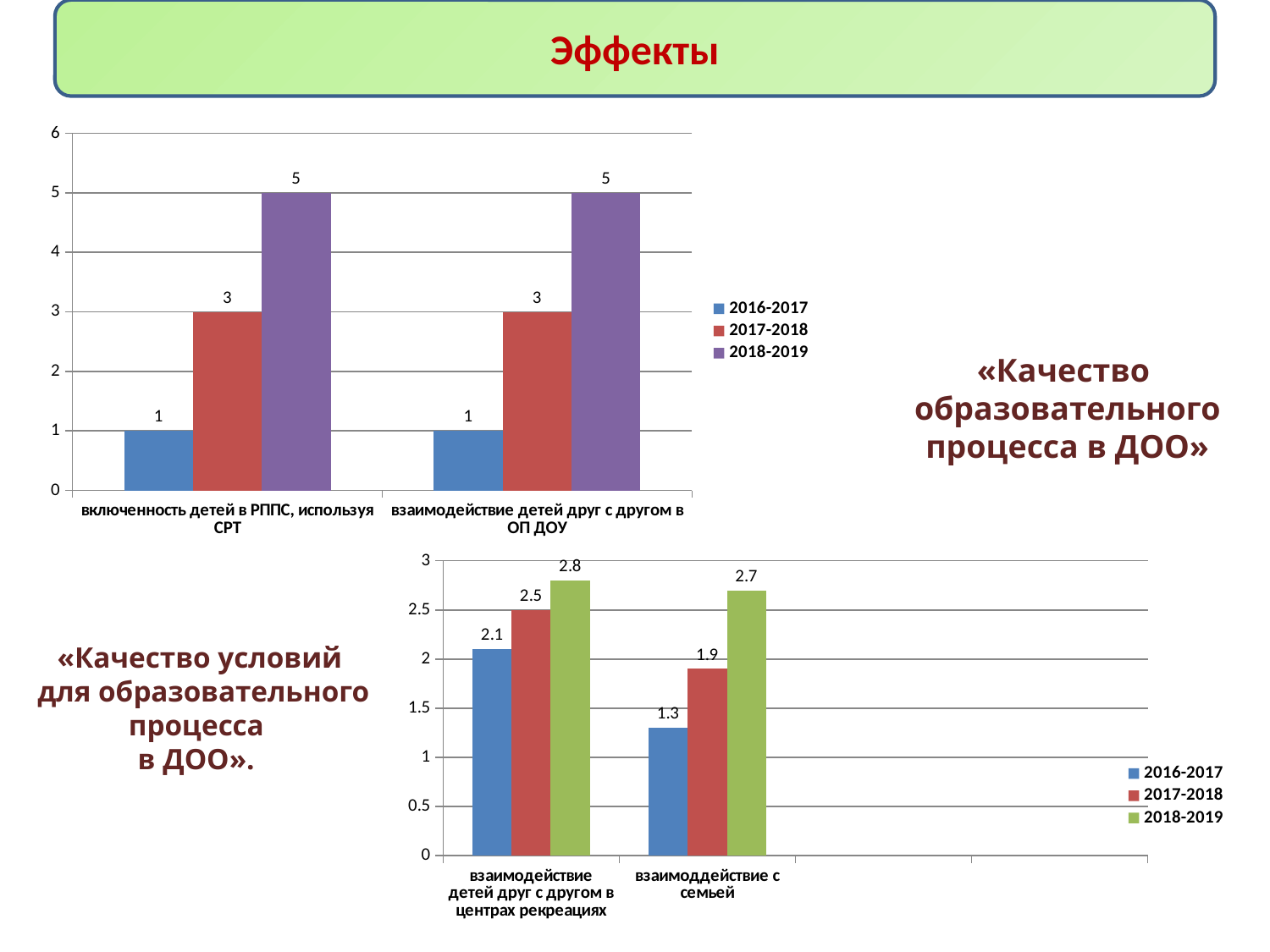
In the bottom chart, which is larger: the 2016-2017 value for "взаимодействие детей друг с другом в центрах рекреациях" or the 2016-2017 value for "взаимоддействие с семьей"? взаимодействие детей друг с другом в центрах рекреациях In the top chart, what is the difference between the 2018-2019 and 2017-2018 values for "взаимодействие детей друг с другом в ОП ДОУ"? 2 In the bottom chart, what is the value for 2017-2018 for "взаимоддействие с семьей"? 1.9 In the top chart, what is the value for 2016-2017 for "взаимодействие детей друг с другом в ОП ДОУ"? 1 In the top chart, how many series does the legend list? 3 In the bottom chart, how many categories are shown on the x axis? 2 What kind of chart is the bottom chart? bar chart In the bottom chart, what is the value for 2018-2019 for "взаимодействие детей друг с другом в центрах рекреациях"? 2.8 In the bottom chart, which series has the lowest value for "взаимоддействие с семьей"? 2016-2017 In the top chart, do the values rise or fall from 2016-2017 to 2018-2019 for "включенность детей в РППС, используя СРТ"? rise In the top chart, what is the value for 2018-2019 for "включенность детей в РППС, используя СРТ"? 5 In the bottom chart, what is the difference between the 2018-2019 and 2016-2017 values for "взаимоддействие с семьей"? 1.4